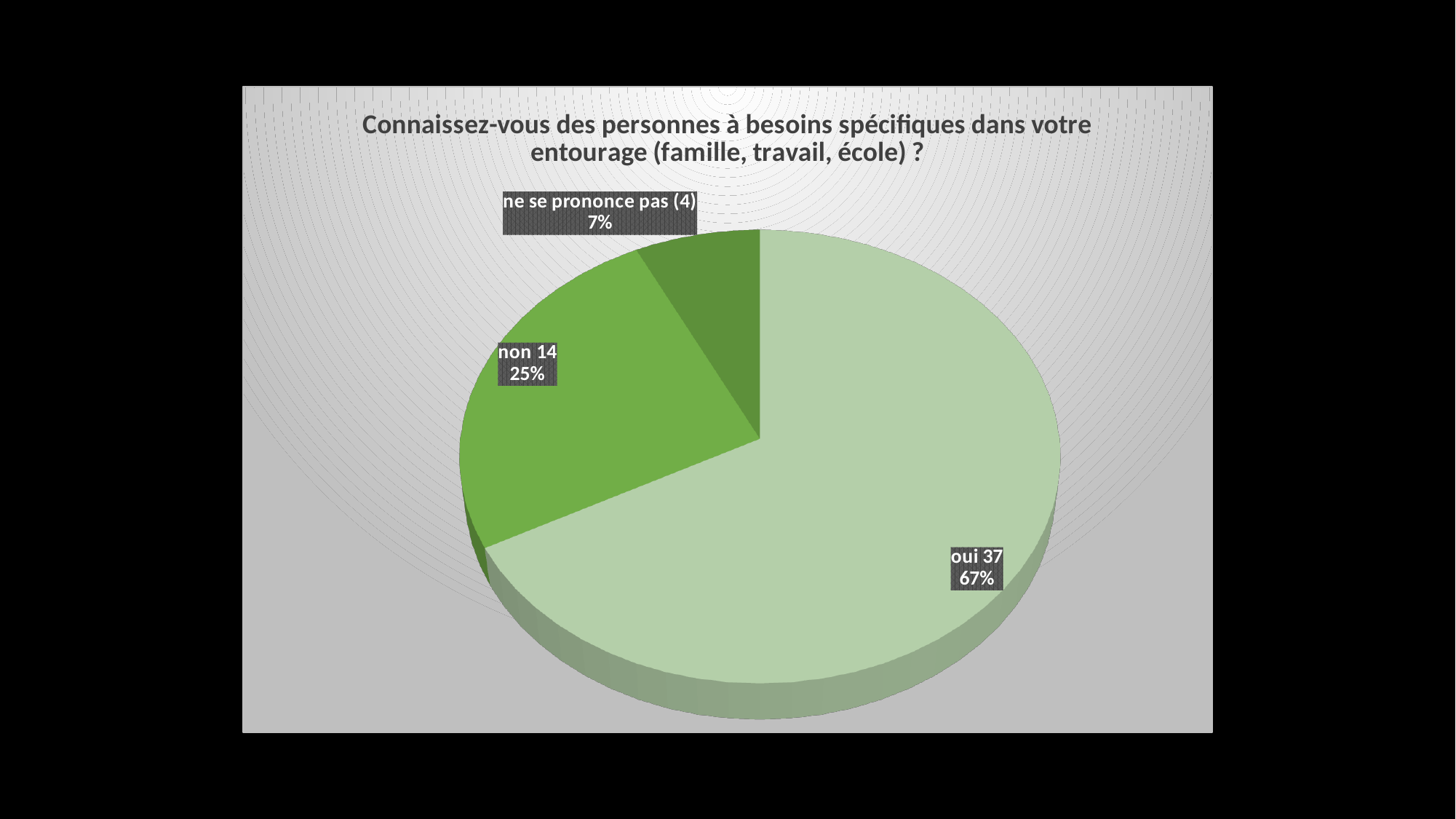
What is the difference in number of respondents between "oui" and "non"? 23 What kind of chart is shown on the slide? pie chart How many respondents answered "oui"? 37 How many slices does the pie chart have? 3 What percentage share does the "ne se prononce pas" slice represent? 7% Which category has the smallest slice? ne se prononce pas How many respondents answered "non"? 14 What percentage share does the "non" slice represent? 25% What percentage share does the "oui" slice represent? 67% What is the title of the chart? Connaissez-vous des personnes à besoins spécifiques dans votre entourage (famille, travail, école) ? How many respondents are in the "ne se prononce pas" category? 4 Which category has the largest slice? oui